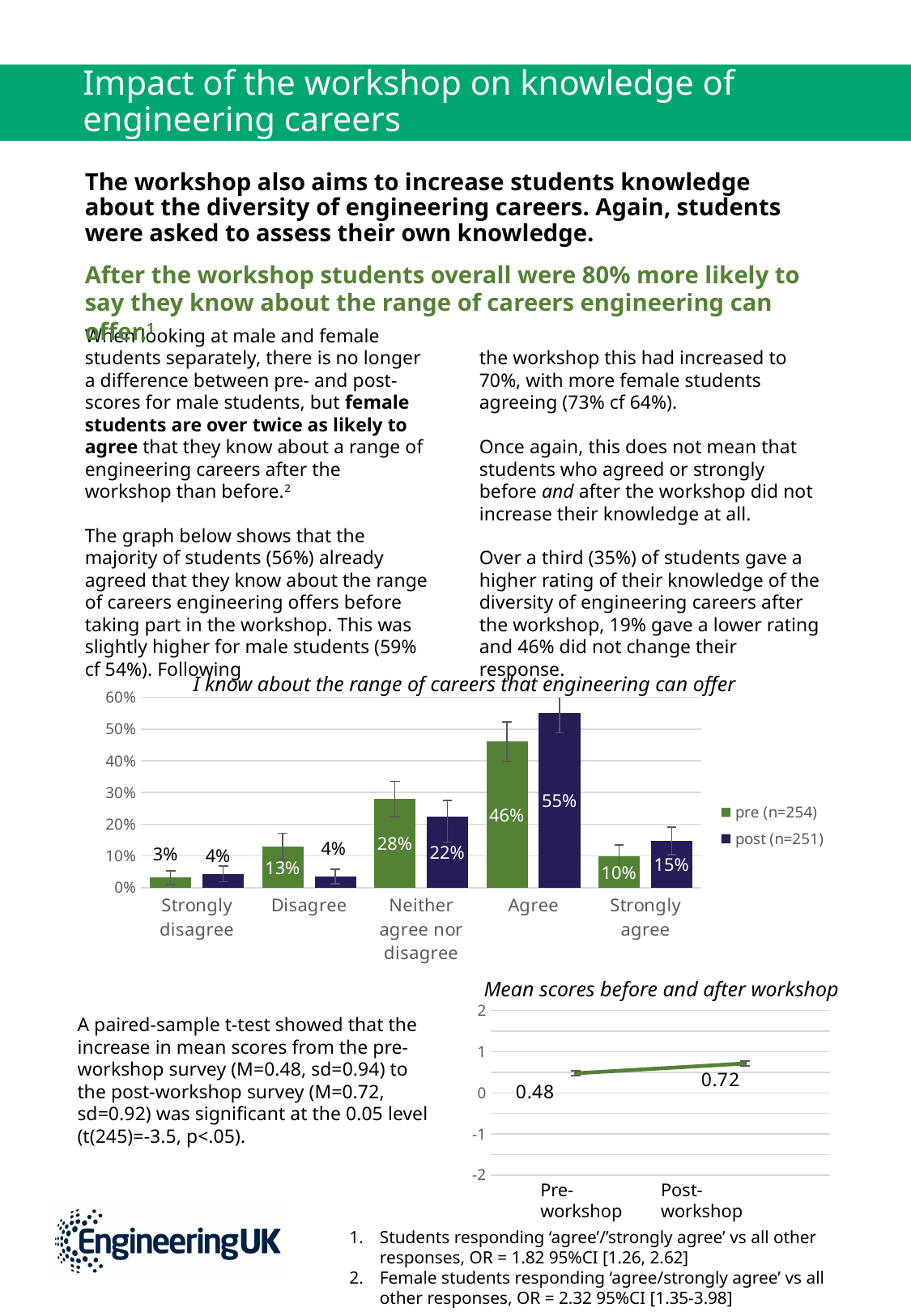
In the chart titled 'I know about the range of careers that engineering can offer', what sample size is given in the legend for the 'post' series? n=251 In the chart titled 'I know about the range of careers that engineering can offer', what is the post-workshop value for 'Agree'? 55% In the chart titled 'I know about the range of careers that engineering can offer', which category has the highest post-workshop value? Agree In the chart titled 'Mean scores before and after workshop', does the value rise or fall from Pre-workshop to Post-workshop? rise In the chart titled 'I know about the range of careers that engineering can offer', which category has the lowest pre-workshop value? Strongly disagree What kind of chart is the one titled 'I know about the range of careers that engineering can offer'? bar chart In the chart titled 'I know about the range of careers that engineering can offer', what is the pre-workshop value for 'Neither agree nor disagree'? 28% In the chart titled 'Mean scores before and after workshop', what is the value for 'Post-workshop'? 0.72 In the chart titled 'I know about the range of careers that engineering can offer', which is larger for 'Disagree': the pre value or the post value? pre In the chart titled 'I know about the range of careers that engineering can offer', how many series does the legend list? 2 In the chart titled 'I know about the range of careers that engineering can offer', what is the difference between the post and pre values for 'Agree'? 9% In the chart titled 'I know about the range of careers that engineering can offer', how many response categories are shown on the x axis? 5